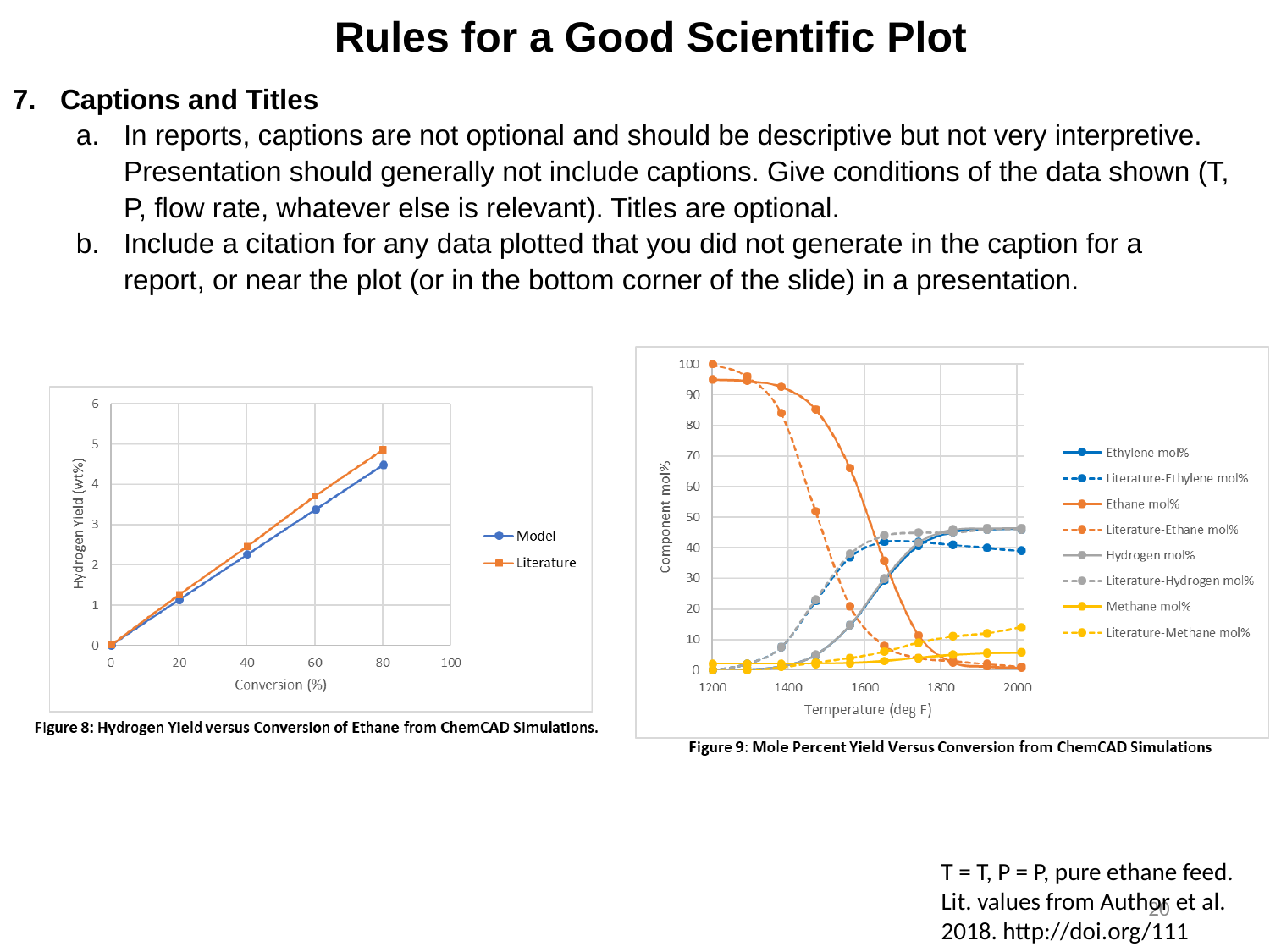
What kind of chart is Figure 8 (Hydrogen Yield versus Conversion)? Line chart In Figure 9 (Mole Percent Yield), at 1200 deg F, which series is higher, Ethane mol% or Ethylene mol%? Ethane mol% In Figure 9 (Mole Percent Yield), how many series does the legend list? 8 In Figure 8 (Hydrogen Yield versus Conversion), how many series does the legend list? 2 In Figure 8 (Hydrogen Yield versus Conversion), at 80% conversion, which series has the higher hydrogen yield, Model or Literature? Literature In Figure 8 (Hydrogen Yield versus Conversion), is the Literature value at 80% conversion greater or less than 4? greater In Figure 8 (Hydrogen Yield versus Conversion), does the Model series rise or fall as Conversion increases? Rise In Figure 9 (Mole Percent Yield), does the Ethane mol% series rise or fall as Temperature increases? Fall What is the x-axis label of Figure 9 (Mole Percent Yield)? Temperature (deg F) In Figure 9 (Mole Percent Yield), is the Ethane mol% value at 1200 deg F greater or less than 90? greater In Figure 8 (Hydrogen Yield versus Conversion), is the Model value at 40% conversion greater or less than 3? less